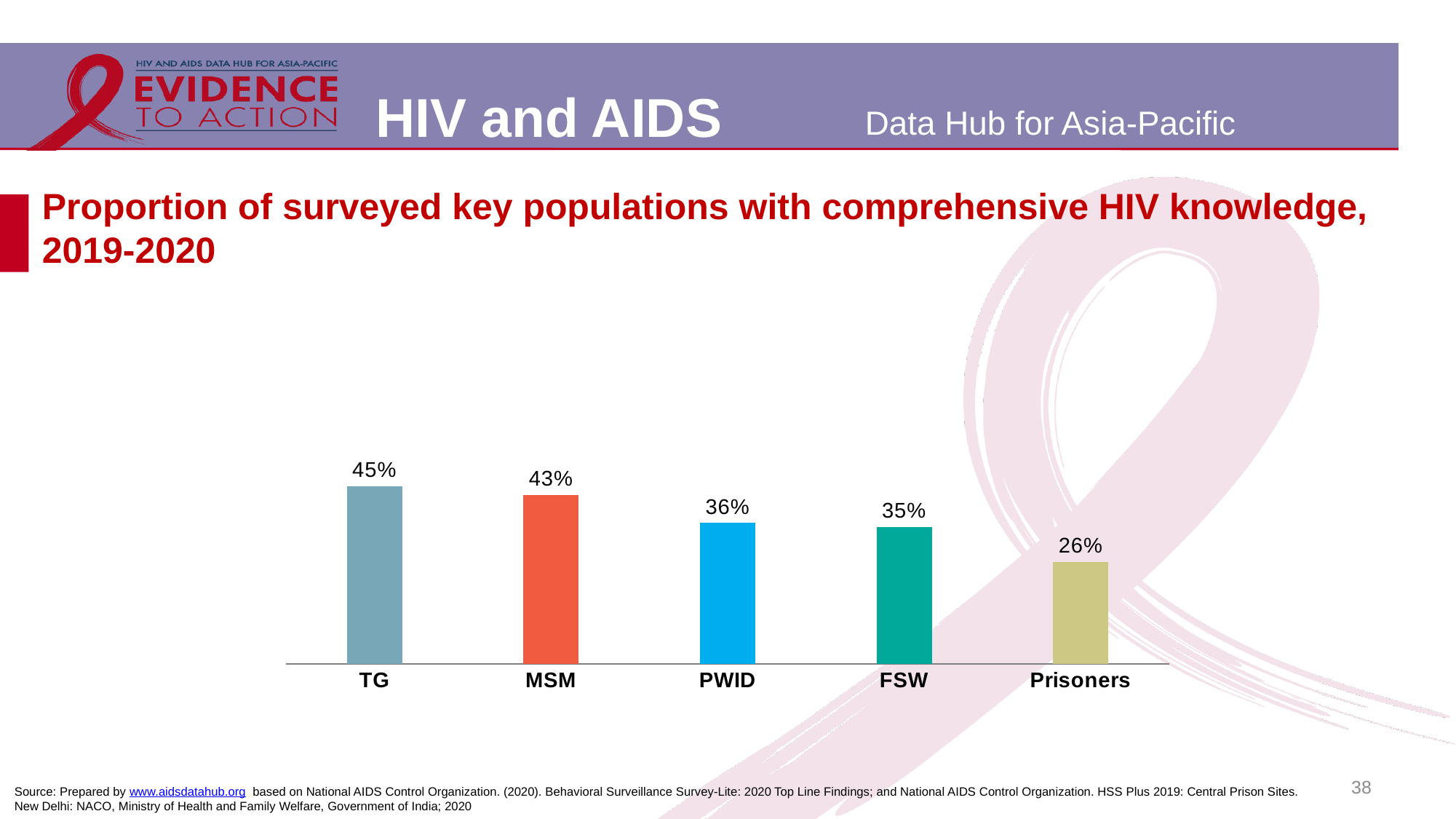
Which key population has the highest proportion with comprehensive HIV knowledge? TG What is the value shown for FSW? 35% What is the value shown for MSM? 43% What is the value shown for PWID? 36% What is the proportion of surveyed TG with comprehensive HIV knowledge? 45% Which is larger, the value for TG or the value for MSM? TG Which key population has the lowest proportion with comprehensive HIV knowledge? Prisoners What is the difference in percentage points between TG and Prisoners? 19 percentage points How many key populations are shown in the chart? 5 What is the value shown for Prisoners? 26% What type of chart is shown on the slide? Bar chart What is the difference in percentage points between MSM and PWID? 7 percentage points